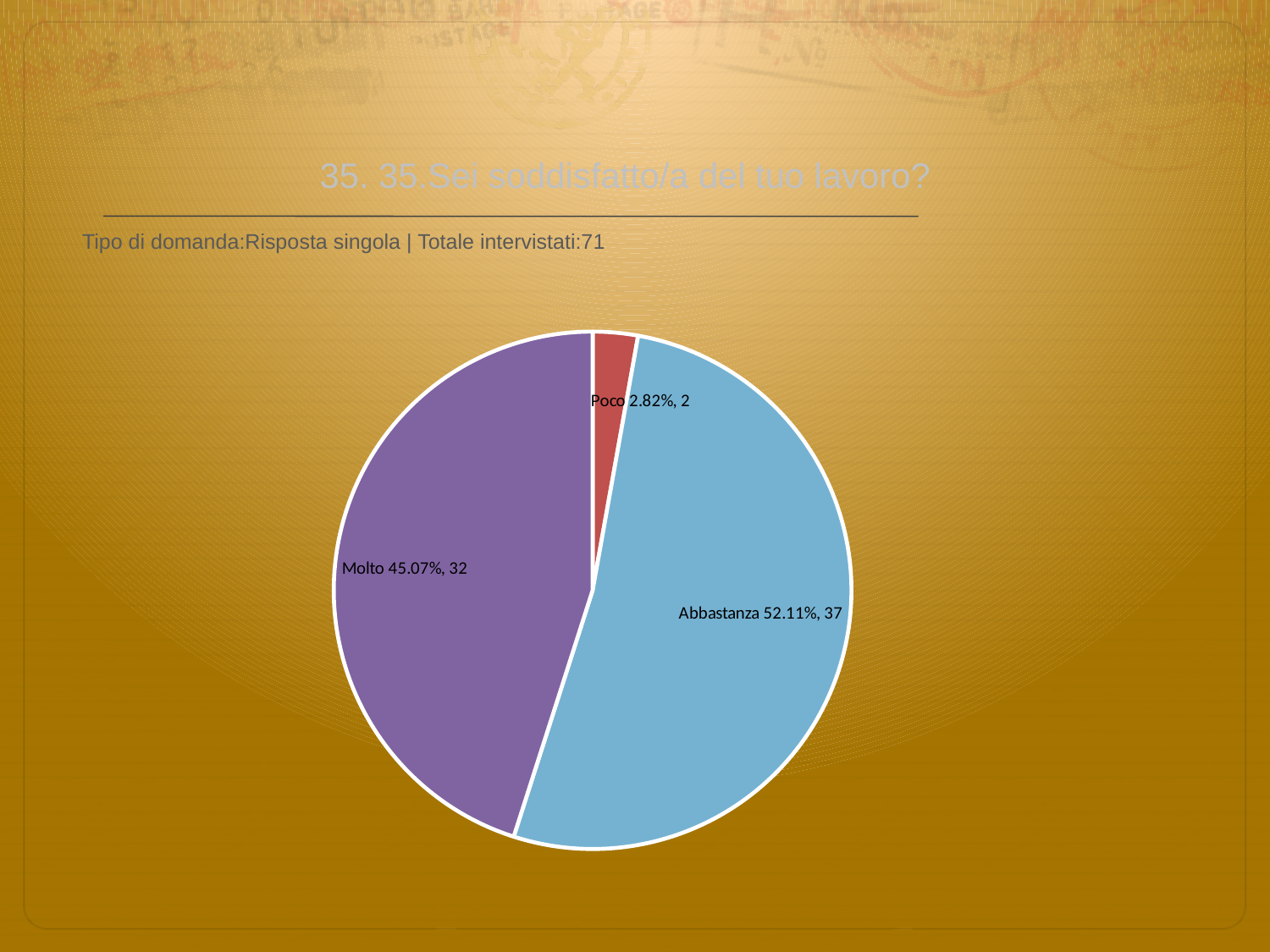
What percentage share does the Molto slice have? 45.07% What is the difference in respondent count between Abbastanza and Molto? 5 What kind of chart is shown on the slide? pie chart Which category has the smallest slice? Poco What percentage share does the Abbastanza slice have? 52.11% What percentage share does the Poco slice have? 2.82% How many respondents answered Molto? 32 How many slices does the pie chart have? 3 Which category has the largest slice? Abbastanza How many respondents answered Poco? 2 How many respondents answered Abbastanza? 37 Which has more respondents, Molto or Poco? Molto